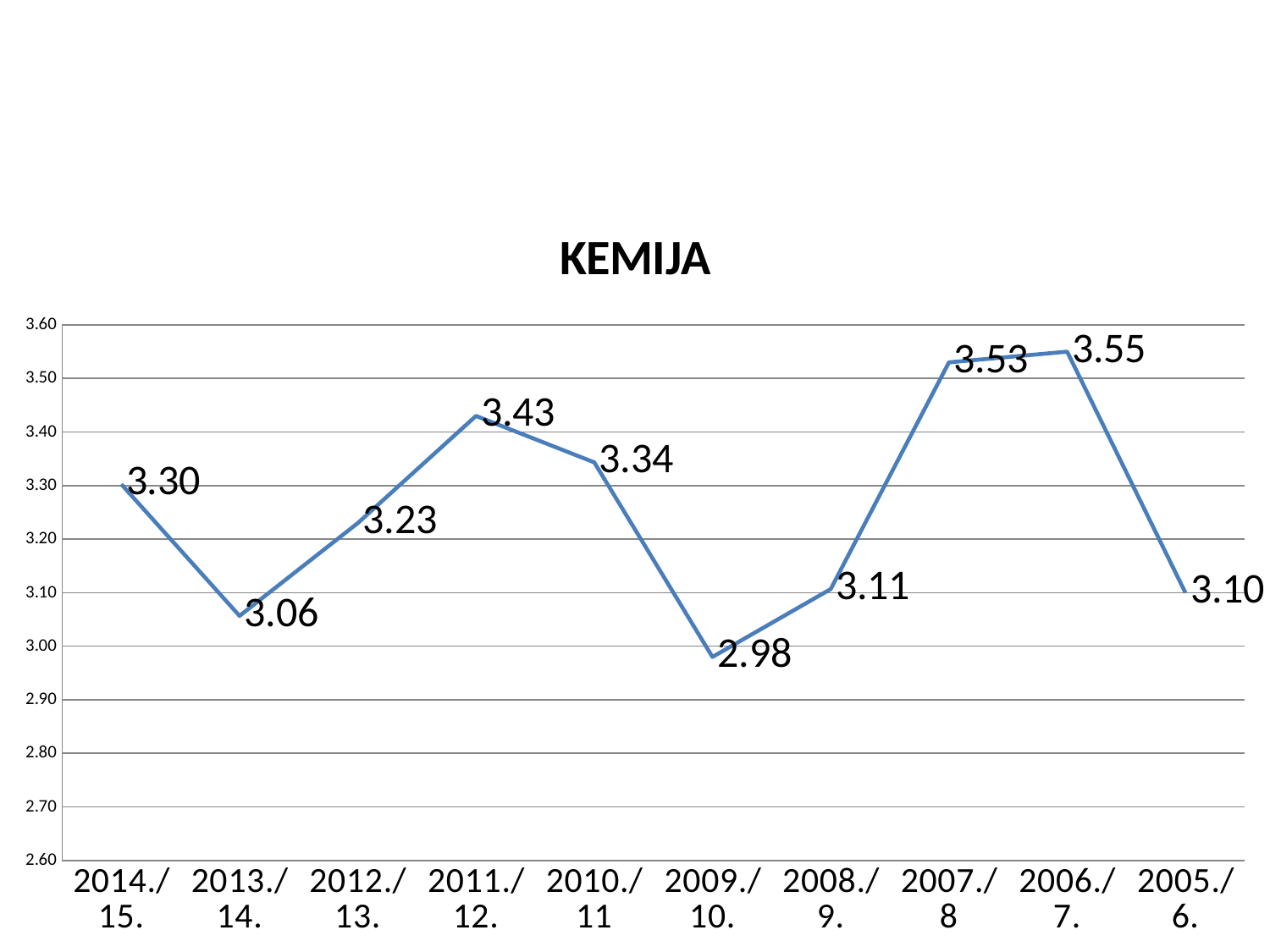
Which category has the lowest value? 2009./10. What is the value for 2014./15.? 3.30 Which category has the highest value? 2006./7. What is the title of the chart? KEMIJA Is the value for 2008./9. greater or less than 3.20? less Does the value rise or fall from 2007./8 to 2006./7.? rise What is the value for 2009./10.? 2.98 How many categories are shown on the x axis? 10 What kind of chart is this? line chart Which is larger, the value for 2012./13. or the value for 2010./11? 2010./11 What is the value for 2011./12.? 3.43 What is the difference between the values for 2006./7. and 2009./10.? 0.57